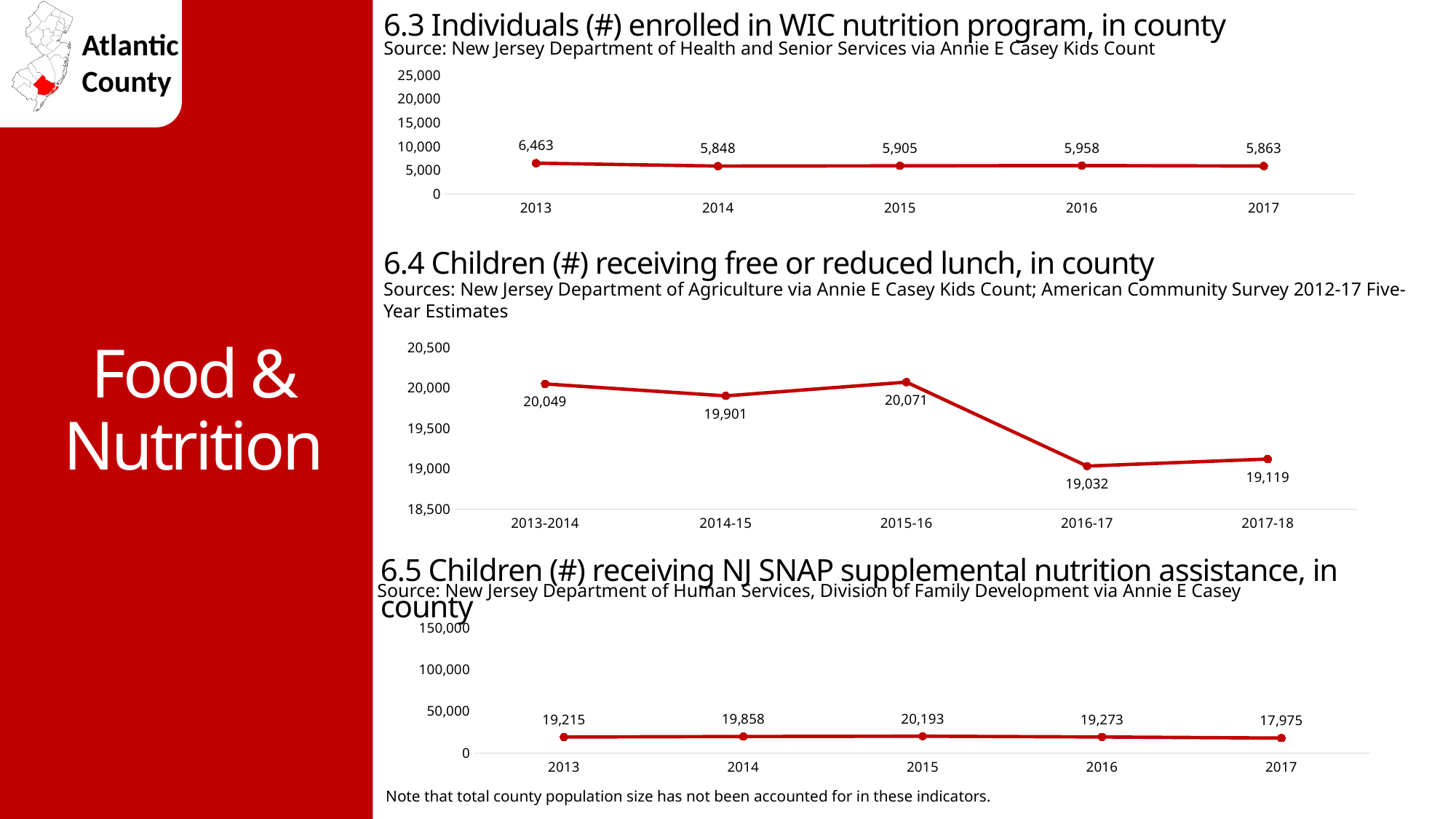
In the chart '6.4 Children (#) receiving free or reduced lunch, in county', what is the value for 2016-17? 19,032 In the chart '6.3 Individuals (#) enrolled in WIC nutrition program, in county', which year has the lowest value? 2014 What kind of chart is '6.4 Children (#) receiving free or reduced lunch, in county'? line chart In the chart '6.5 Children (#) receiving NJ SNAP supplemental nutrition assistance, in county', which year has the lowest value? 2017 In the chart '6.3 Individuals (#) enrolled in WIC nutrition program, in county', what is the difference between the 2013 and 2017 values? 600 In the chart '6.4 Children (#) receiving free or reduced lunch, in county', is the value for 2014-15 larger or smaller than the value for 2017-18? larger In the chart '6.5 Children (#) receiving NJ SNAP supplemental nutrition assistance, in county', what is the value for 2015? 20,193 In the chart '6.3 Individuals (#) enrolled in WIC nutrition program, in county', what is the value for 2013? 6,463 In the chart '6.4 Children (#) receiving free or reduced lunch, in county', which period has the highest value? 2015-16 In the chart '6.4 Children (#) receiving free or reduced lunch, in county', what is the difference between the 2015-16 and 2016-17 values? 1,039 In the chart '6.5 Children (#) receiving NJ SNAP supplemental nutrition assistance, in county', is the value for 2016 greater or less than 50,000? less In the chart '6.3 Individuals (#) enrolled in WIC nutrition program, in county', how many years are plotted? 5